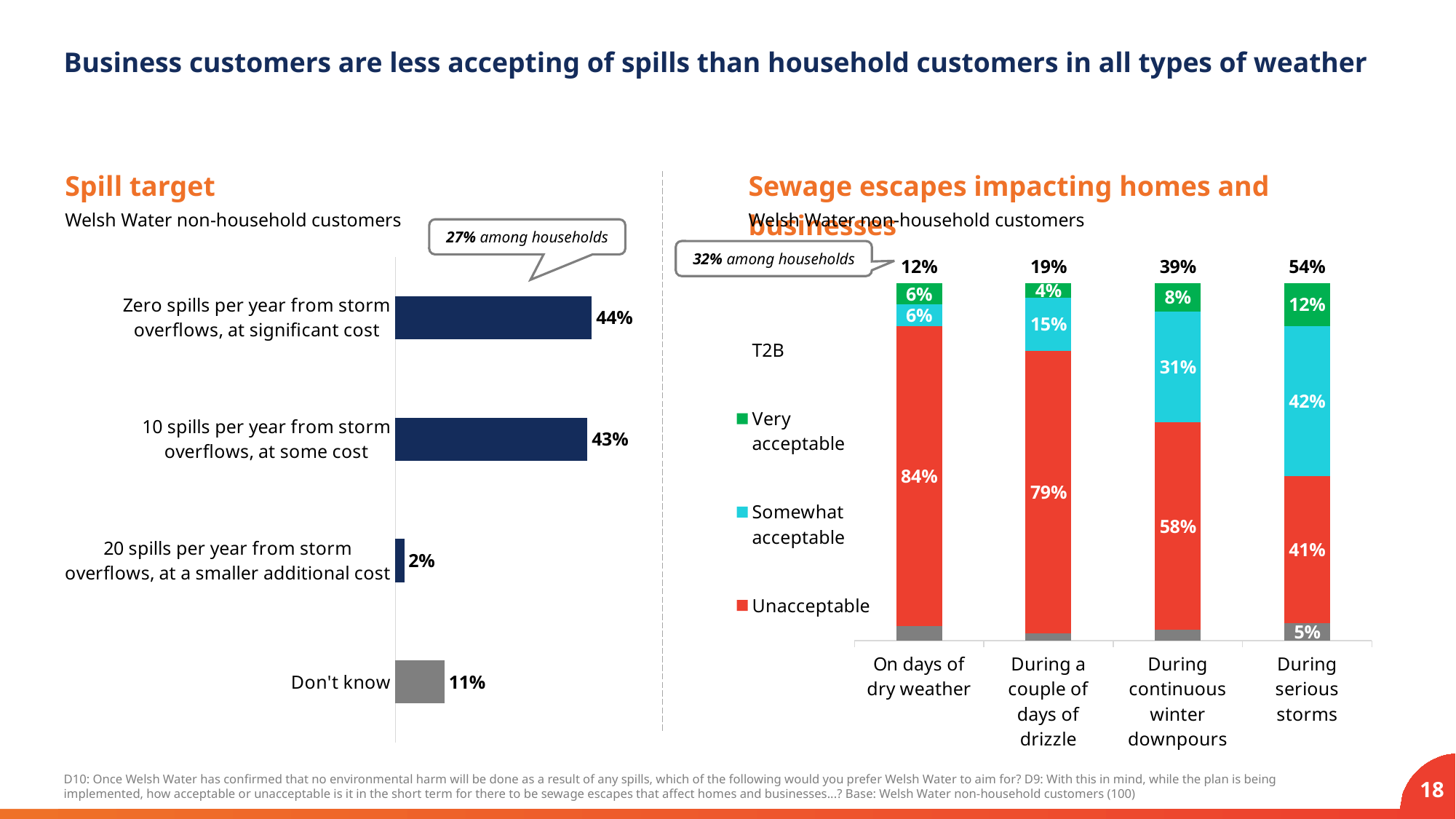
In the Spill target chart, what percentage of non-household customers chose zero spills per year from storm overflows, at significant cost? 44% In the Sewage escapes chart, which weather condition has the highest Unacceptable percentage? On days of dry weather In the Sewage escapes chart, is the Somewhat acceptable share larger for 'During a couple of days of drizzle' or 'During serious storms'? During serious storms In the Sewage escapes chart, what is the T2B value for 'During continuous winter downpours'? 39% In the Spill target chart, which option has the lowest percentage? 20 spills per year from storm overflows, at a smaller additional cost In the Spill target chart, what percentage answered Don't know? 11% In the Sewage escapes chart, what is the difference between the Unacceptable percentages for 'On days of dry weather' and 'During serious storms'? 43% How many series does the legend of the Sewage escapes chart list? 4 In the Spill target chart, how many categories are shown? 4 What kind of chart is the Spill target chart? Bar chart In the Spill target chart, what is the difference between the percentage for 10 spills per year and the percentage for 20 spills per year? 41% In the Sewage escapes chart, what percentage of non-household customers said sewage escapes during serious storms are unacceptable? 41%